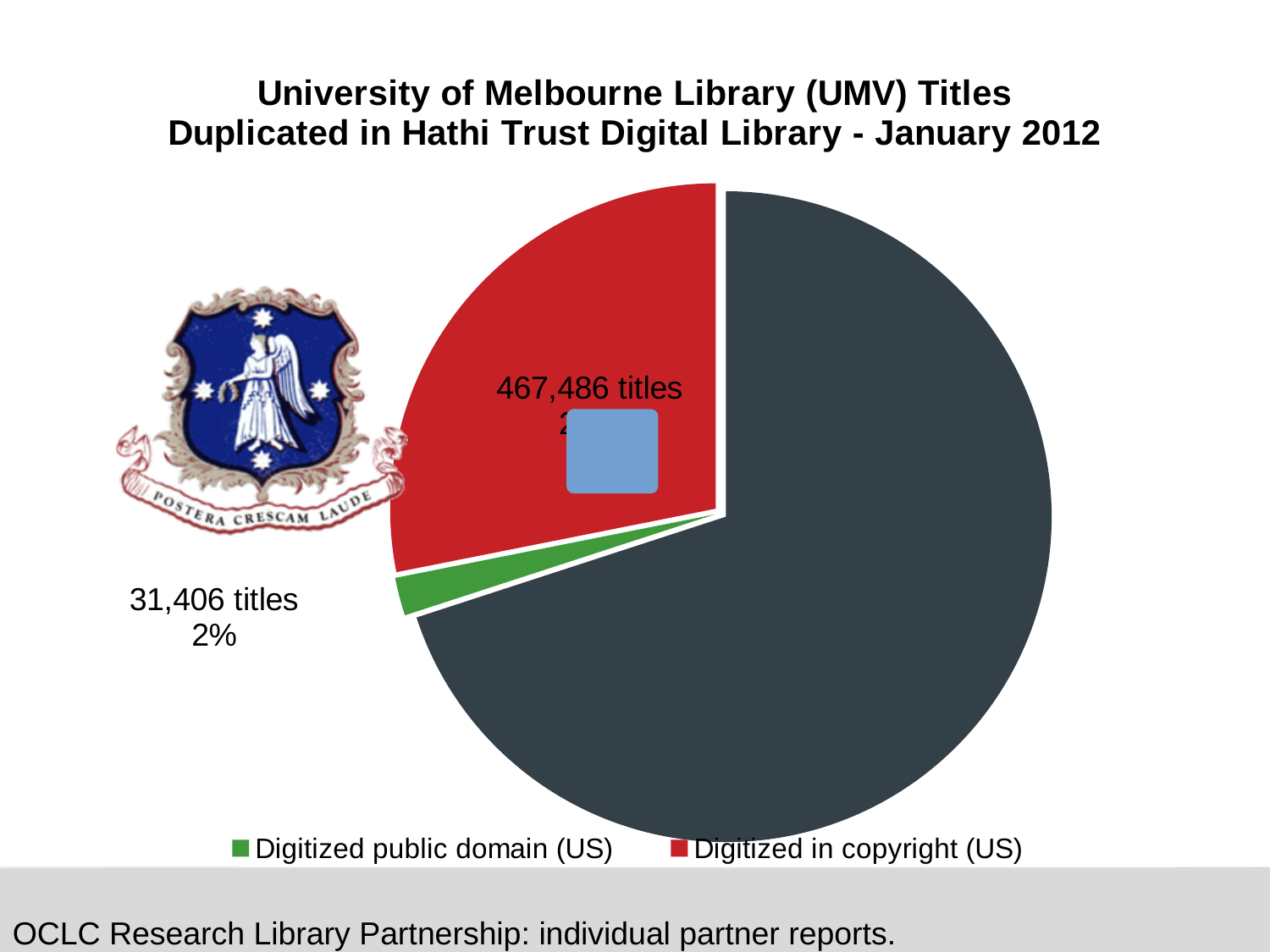
How many titles are in the Digitized in copyright (US) slice? 467,486 titles What is the difference in titles between the Digitized in copyright (US) slice and the Digitized public domain (US) slice? 436,080 titles Which is larger, the Digitized public domain (US) slice or the Digitized in copyright (US) slice? Digitized in copyright (US) Which slice of the pie is the smallest? Digitized public domain (US) What kind of chart is shown on the slide? pie chart What percentage share does the Digitized public domain (US) slice have? 2% How many entries does the legend list? 2 What colour represents Digitized public domain (US) in the legend? green What is the title of the chart? University of Melbourne Library (UMV) Titles Duplicated in Hathi Trust Digital Library - January 2012 How many titles are in the Digitized public domain (US) slice? 31,406 titles How many slices does the pie chart have? 3